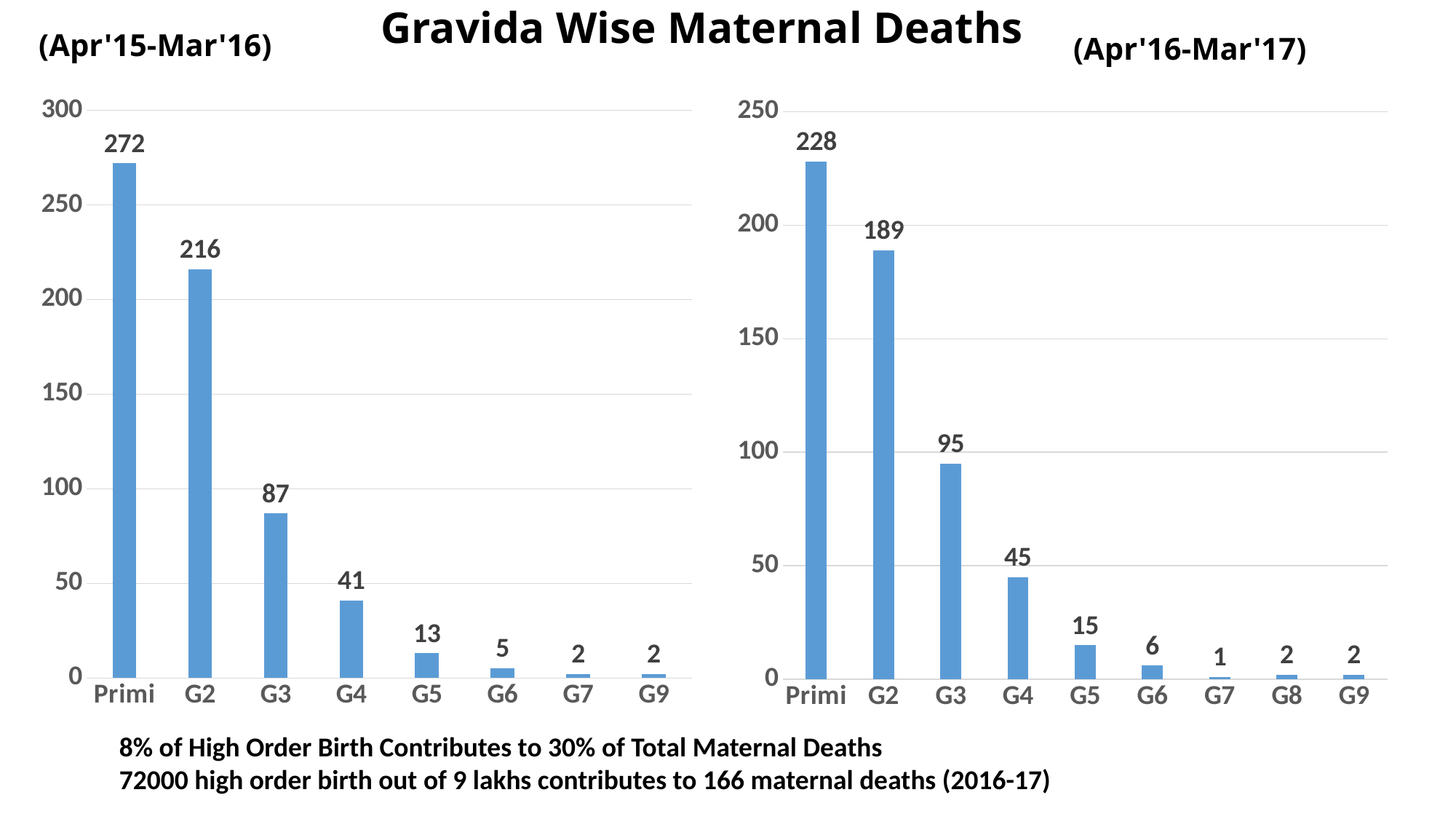
In the Apr'15-Mar'16 chart, what is the difference between the values for Primi and G2? 56 In the Apr'15-Mar'16 chart, do the values rise or fall from Primi to G5? Fall In the Apr'15-Mar'16 chart, which category has the highest value? Primi In the Apr'16-Mar'17 chart, what is the difference between the values for G2 and G3? 94 In the Apr'15-Mar'16 chart, what is the value for G3? 87 In the Apr'16-Mar'17 chart, which category has the lowest value? G7 Which is larger: the value for Primi in the Apr'15-Mar'16 chart or the value for Primi in the Apr'16-Mar'17 chart? Apr'15-Mar'16 In the Apr'16-Mar'17 chart, is the value for G2 greater or less than 150? greater How many categories are shown in the Apr'16-Mar'17 chart? 9 What kind of chart is the Apr'16-Mar'17 chart? Bar chart In the Apr'16-Mar'17 chart, what is the value for G4? 45 How many categories are shown in the Apr'15-Mar'16 chart? 8